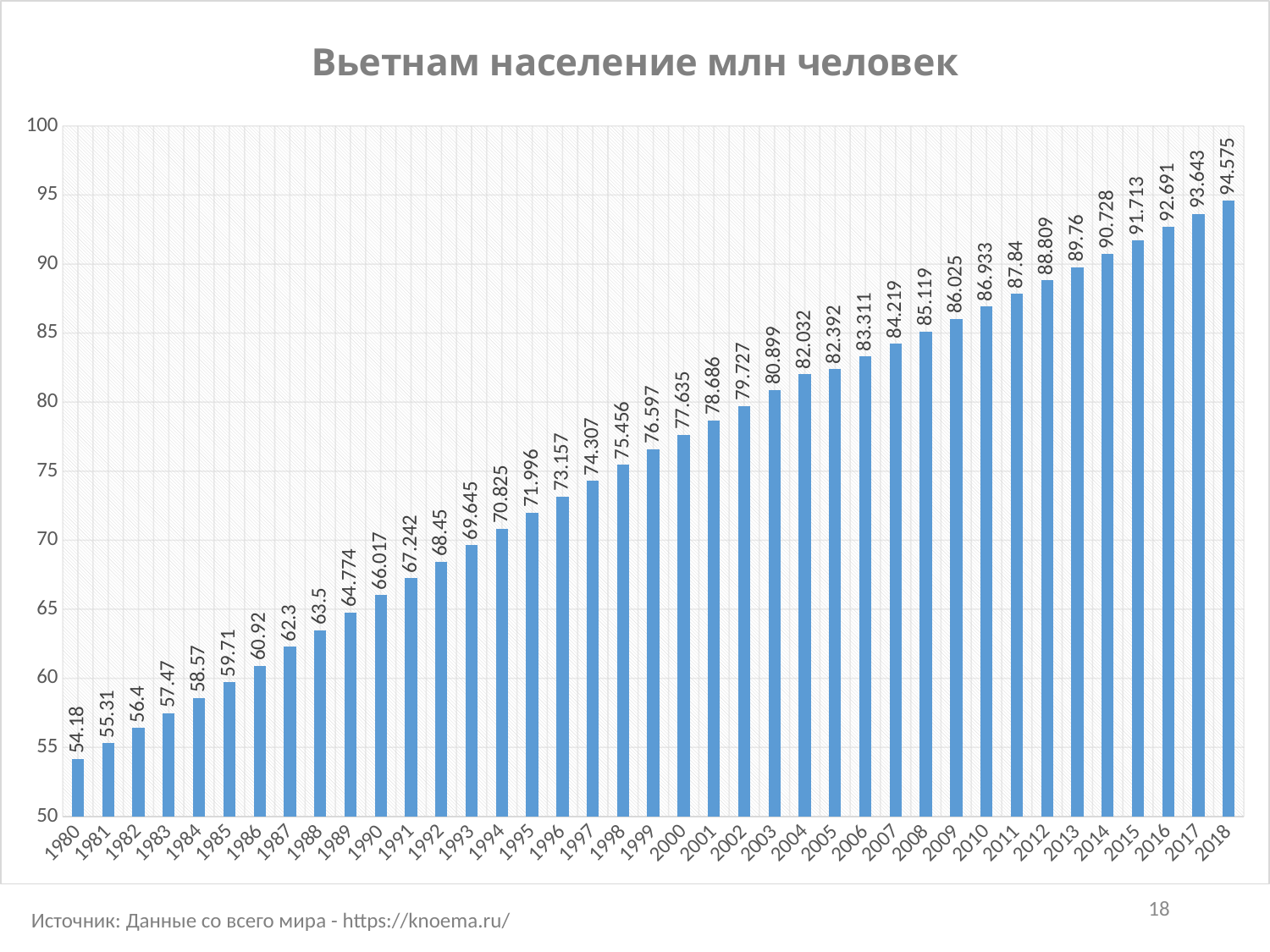
Which year has the highest population value? 2018 Which year has the lowest population value? 1980 What is the difference between the values for 2000 and 1990? 11.618 Do the values rise or fall from 1980 to 2018? Rise What is the difference between the values for 2018 and 1980? 40.395 What is the population value shown for 1995? 71.996 What is the population value shown for 1980? 54.18 Which is larger, the value for 2005 or the value for 2010? 2010 How many years (bars) are shown on the chart? 39 What is the population value shown for 2000? 77.635 What is the population value shown for 2018? 94.575 What kind of chart is this? Bar chart